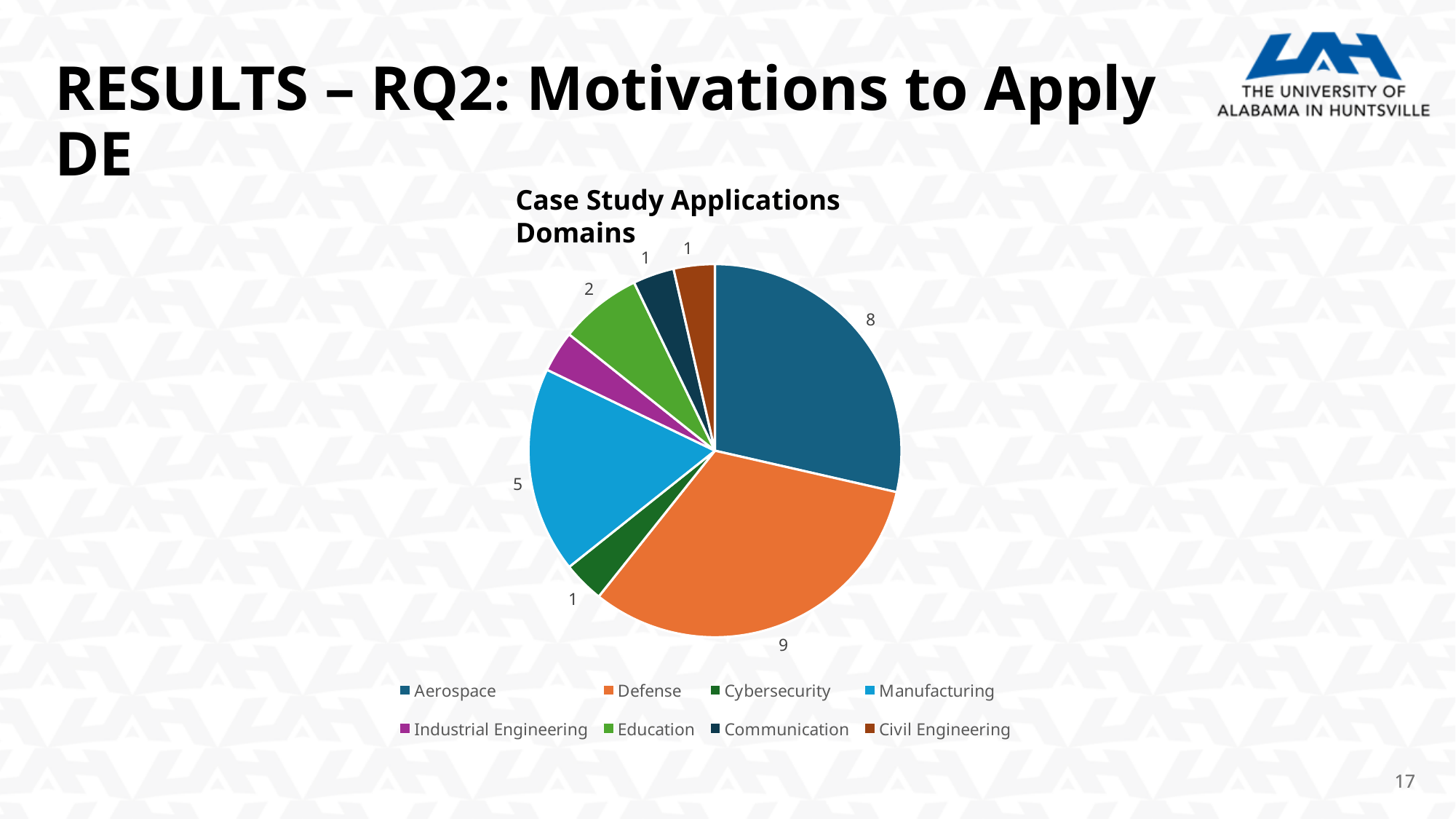
What is the value for Cybersecurity? 1 How many categories does the legend of the pie chart list? 8 What is the difference between the values for Defense and Aerospace? 1 What is the title of the chart? Case Study Applications Domains What is the difference between the values for Manufacturing and Education? 3 Which is larger, the value for Aerospace or the value for Manufacturing? Aerospace Which category has the largest slice of the pie? Defense What is the value for Education? 2 What type of chart is shown on the slide? pie chart What is the value for Manufacturing? 5 What is the value for Aerospace? 8 What is the value for Defense? 9